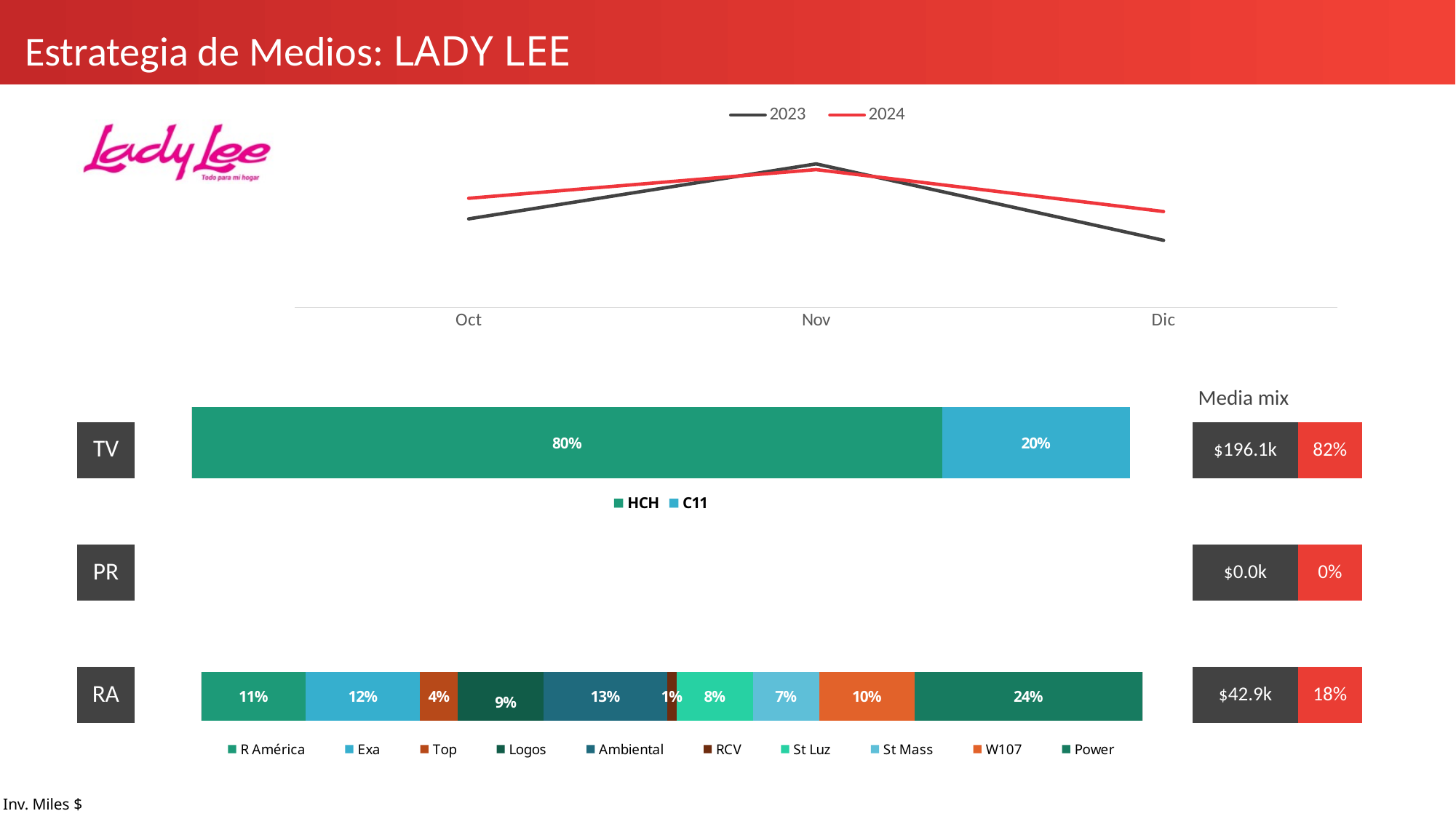
In the TV bar, what is the difference between the HCH and C11 shares? 60% In the RA bar, which station has the smallest share? RCV In the RA bar, which station has the largest share? Power In the line chart at the top, which series has the higher value at Dic, 2023 or 2024? 2024 In the line chart at the top, how many series does the legend list? 2 In the line chart at the top, how many months are shown on the x axis? 3 In the TV bar, what share does HCH have? 80% In the Media mix column, what is the investment shown for TV? $196.1k In the RA bar, what share does Ambiental have? 13% In the line chart at the top, does the 2023 line rise or fall from Nov to Dic? fall In the Media mix column, what percentage is shown for RA? 18% In the RA bar, how many stations does the legend list? 10